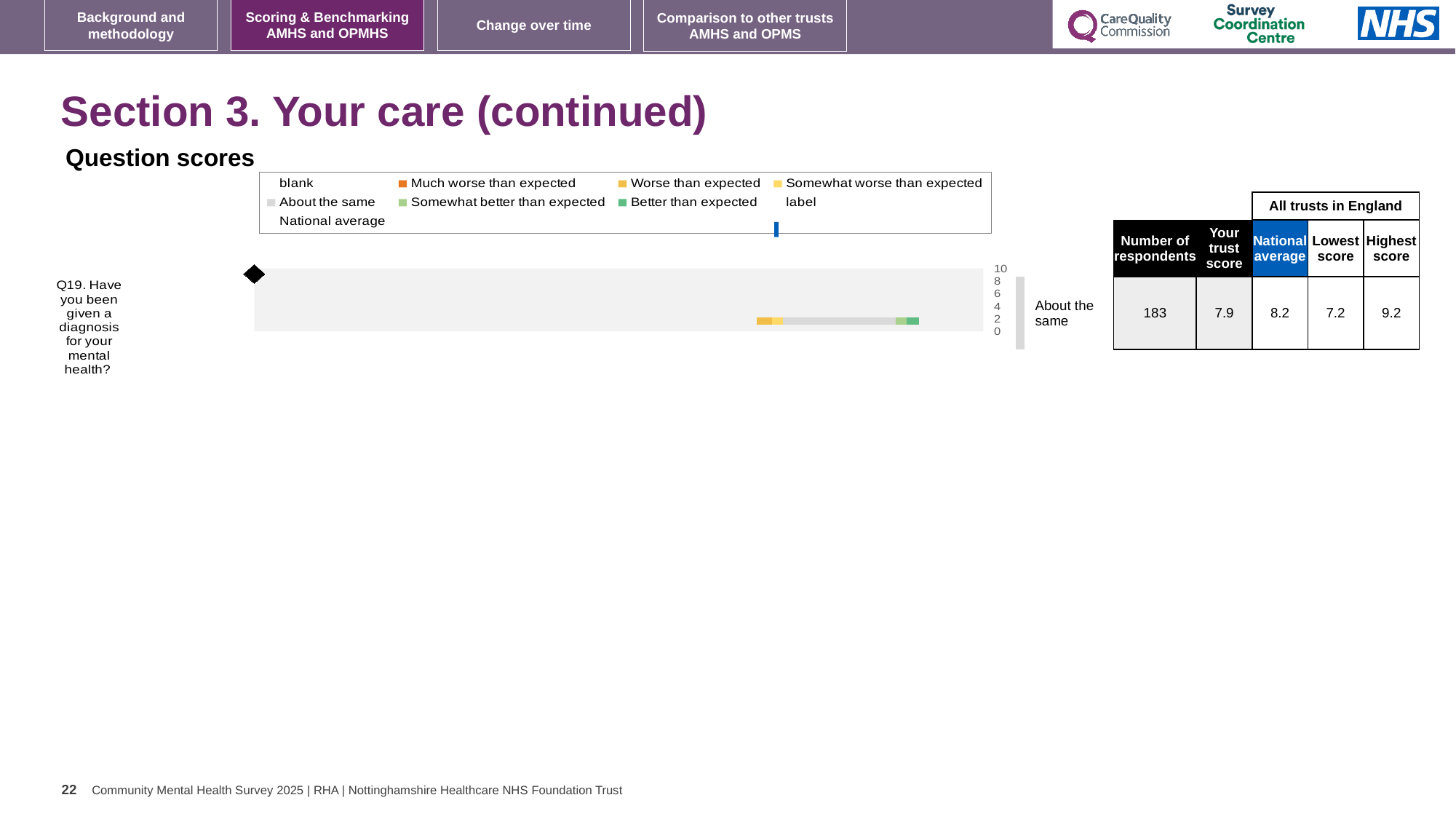
What is the difference between the highest score and the lowest score for Q19? 2.0 How many entries does the chart legend list? 9 In the table beside the chart, what is the trust's score for Q19? 7.9 Which is larger for Q19, the trust's score or the national average? National average Which question is plotted on the chart? Q19. Have you been given a diagnosis for your mental health? What kind of chart is used to show the Q19 question score? bar chart In the table beside the chart, how many respondents answered Q19? 183 In the table beside the chart, what is the lowest score among all trusts in England for Q19? 7.2 What benchmark category is shown next to the bar for Q19? About the same In the table beside the chart, what is the national average for Q19? 8.2 How many questions are plotted on the chart? 1 In the table beside the chart, what is the highest score among all trusts in England for Q19? 9.2